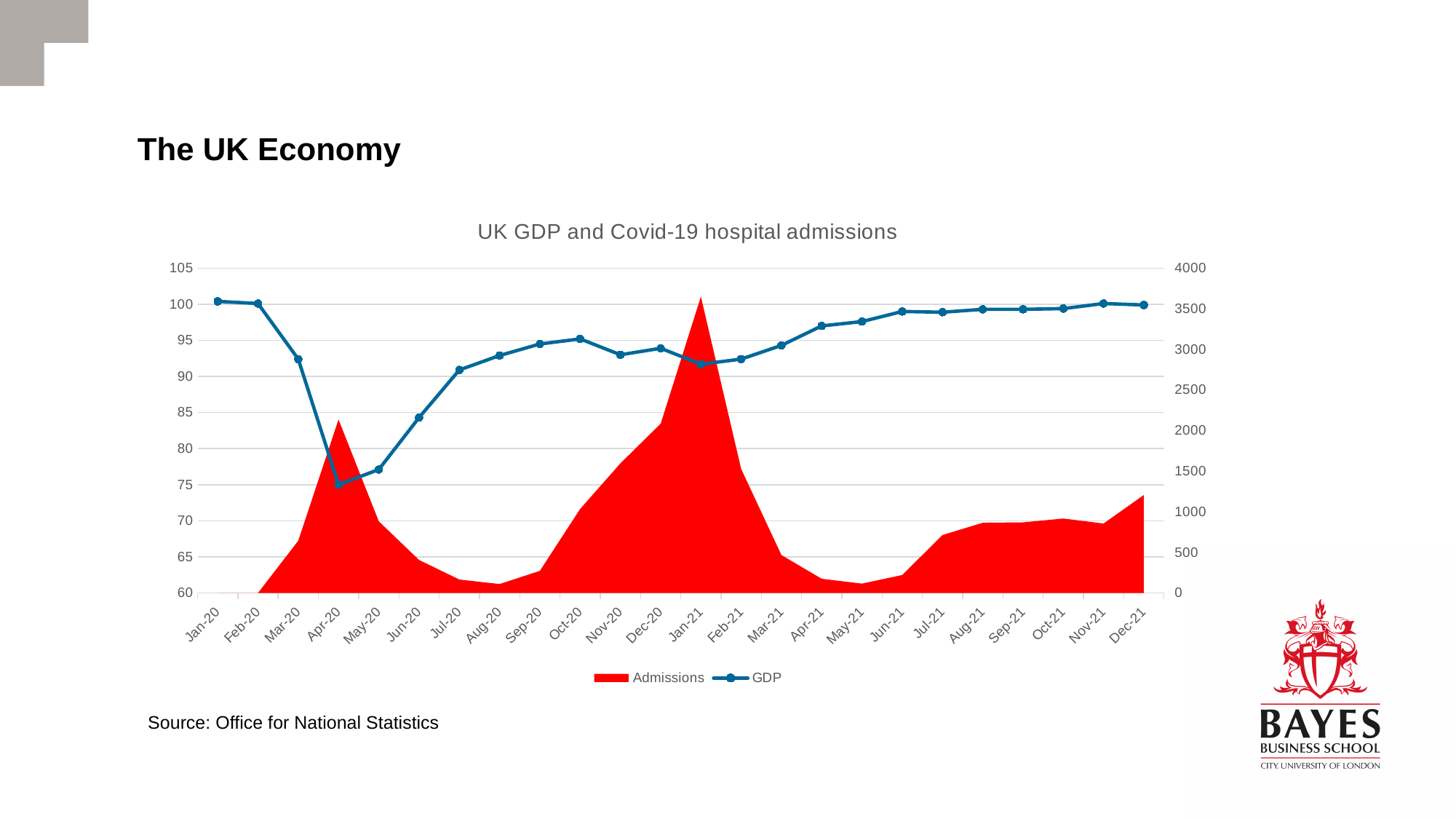
What kind of chart is shown on the slide? A combination chart with an area series and a line series How many months are plotted along the x axis? 24 Is the Admissions value for Jan-21 greater or less than 3000? greater What is the title of the chart? UK GDP and Covid-19 hospital admissions Which is larger, GDP in Feb-20 or GDP in Apr-20? Feb-20 Is the GDP value for Jan-20 greater or less than 95? greater Is the GDP value for Apr-20 greater or less than 80? less In which month are Admissions at their highest? Jan-21 How many series does the legend list? 2 What colour is used for the Admissions series? Red Does GDP rise or fall between Apr-20 and Oct-20? rise In which month is GDP at its lowest? Apr-20